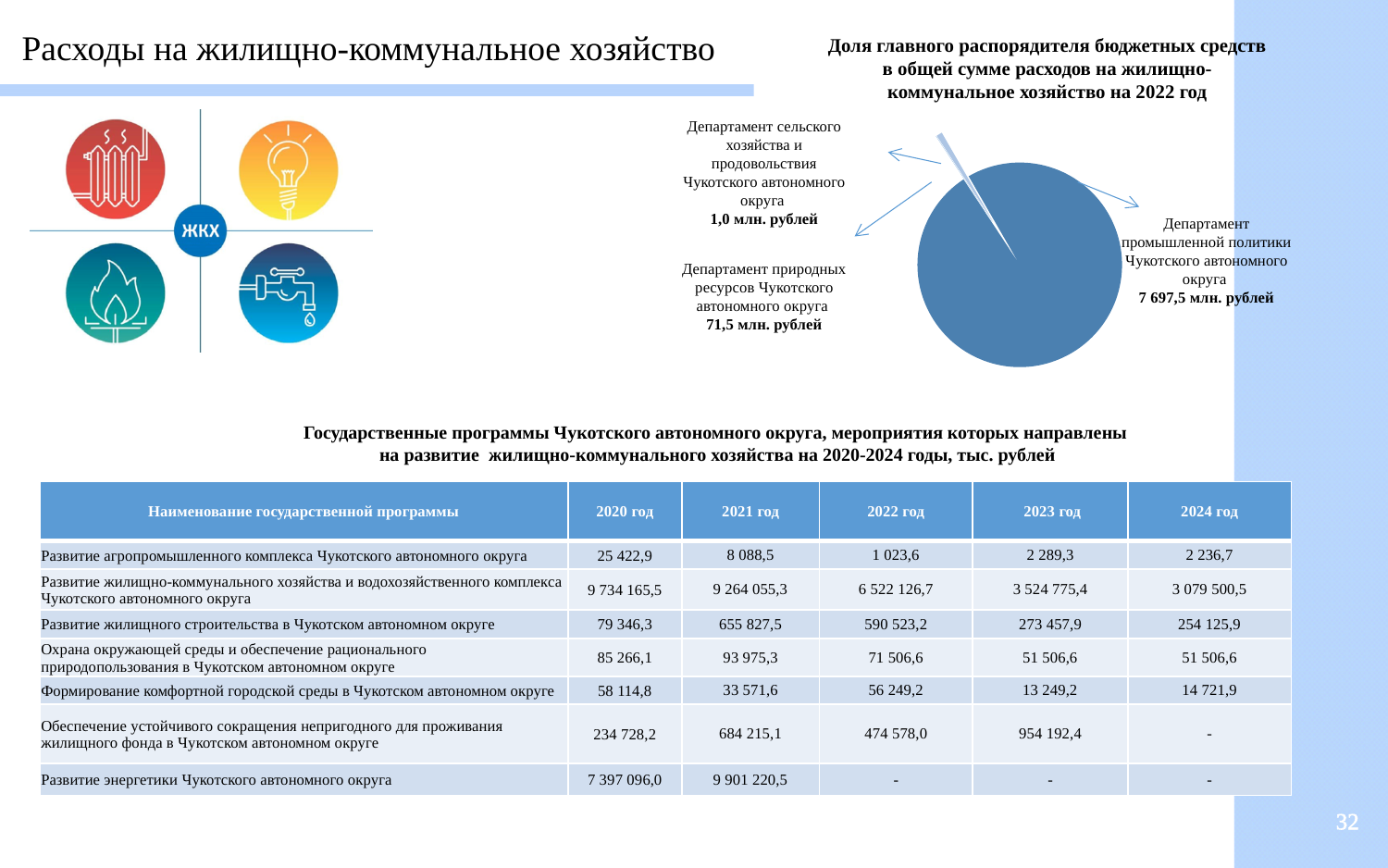
In the pie chart, which is larger: the value for Департамент природных ресурсов or for Департамент сельского хозяйства и продовольствия? Департамент природных ресурсов In the pie chart, what is the value for Департамент промышленной политики Чукотского автономного округа? 7 697,5 млн. рублей How many slices does the pie chart have? 3 For which year does the pie chart show the share of budget administrators in housing and utilities expenditure? 2022 In the pie chart, what is the value for Департамент сельского хозяйства и продовольствия Чукотского автономного округа? 1,0 млн. рублей In the pie chart, what is the difference between the value for Департамент природных ресурсов and the value for Департамент сельского хозяйства и продовольствия? 70,5 млн. рублей What kind of chart is shown under the title 'Доля главного распорядителя бюджетных средств в общей сумме расходов на жилищно-коммунальное хозяйство на 2022 год'? pie chart In the pie chart, what is the value for Департамент природных ресурсов Чукотского автономного округа? 71,5 млн. рублей What is the total of the three values shown in the pie chart? 7 770,0 млн. рублей In the pie chart, what is the difference between the value for Департамент промышленной политики and the value for Департамент природных ресурсов? 7 626,0 млн. рублей Which department has the smallest slice in the pie chart? Департамент сельского хозяйства и продовольствия Чукотского автономного округа Which department has the largest slice in the pie chart? Департамент промышленной политики Чукотского автономного округа